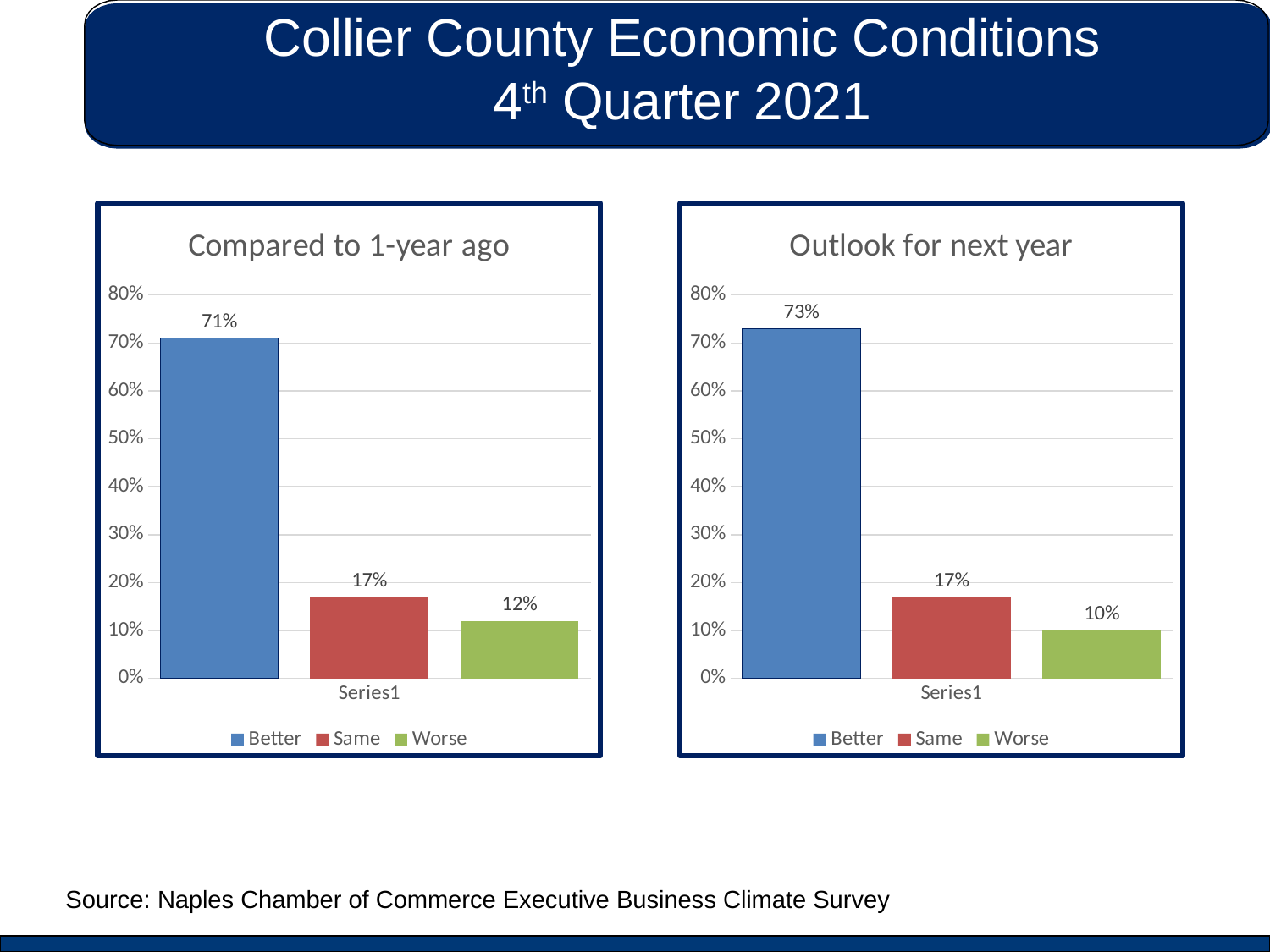
In the 'Compared to 1-year ago' chart, what colour is the Same bar? Red Which chart shows a larger value for Better, 'Compared to 1-year ago' or 'Outlook for next year'? Outlook for next year How many series does the legend list in the 'Compared to 1-year ago' chart? 3 In the 'Outlook for next year' chart, is the value for Better greater or less than 70%? greater In the 'Compared to 1-year ago' chart, what is the value for Same? 17% What kind of chart is the 'Outlook for next year' chart? Bar chart In the 'Compared to 1-year ago' chart, what is the value for Better? 71% In the 'Outlook for next year' chart, what is the value for Worse? 10% In the 'Outlook for next year' chart, what is the difference between the Better and Same values? 56% In the 'Outlook for next year' chart, which series has the highest value? Better In the 'Compared to 1-year ago' chart, what is the difference between the Same and Worse values? 5% In the 'Compared to 1-year ago' chart, which series has the lowest value? Worse